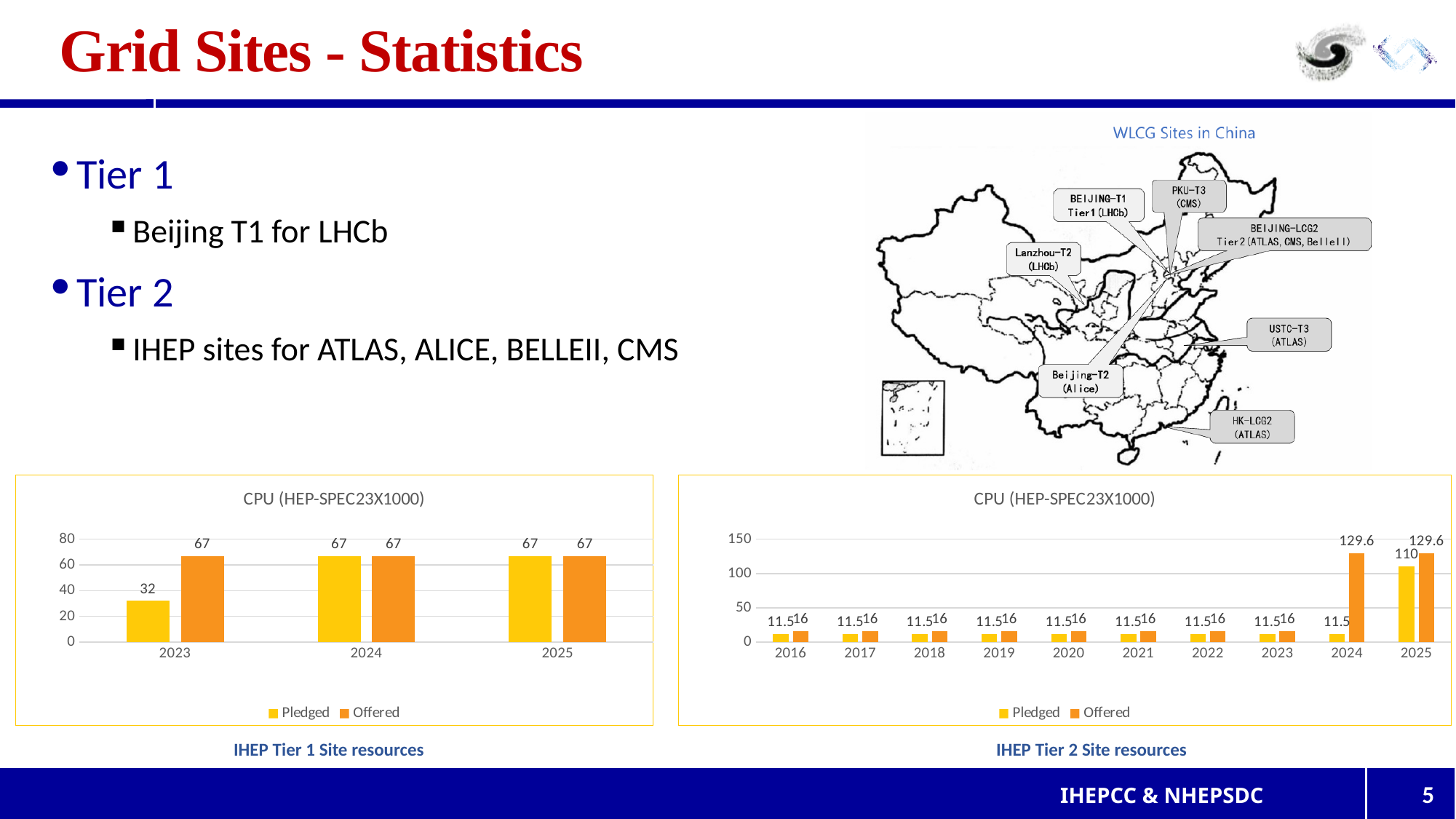
In the right chart (IHEP Tier 2 Site resources), what is the Offered value for 2024? 129.6 In the right chart (IHEP Tier 2 Site resources), what is the Pledged value for 2025? 110 In the left chart (IHEP Tier 1 Site resources), what is the difference between the Offered and Pledged values for 2023? 35 In the left chart (IHEP Tier 1 Site resources), how many years are shown on the x axis? 3 In the right chart (IHEP Tier 2 Site resources), what is the Pledged value for 2019? 11.5 In the right chart (IHEP Tier 2 Site resources), what is the difference between the Offered and Pledged values for 2024? 118.1 In the right chart (IHEP Tier 2 Site resources), is the Offered value for 2024 greater or less than 100? greater How many series does the legend of the right chart (IHEP Tier 2 Site resources) list? 2 In the left chart (IHEP Tier 1 Site resources), what is the Offered value for 2023? 67 In the left chart (IHEP Tier 1 Site resources), what is the Pledged value for 2023? 32 In the left chart (IHEP Tier 1 Site resources), which year has the lowest Pledged value? 2023 In the right chart (IHEP Tier 2 Site resources), how many years are shown on the x axis? 10